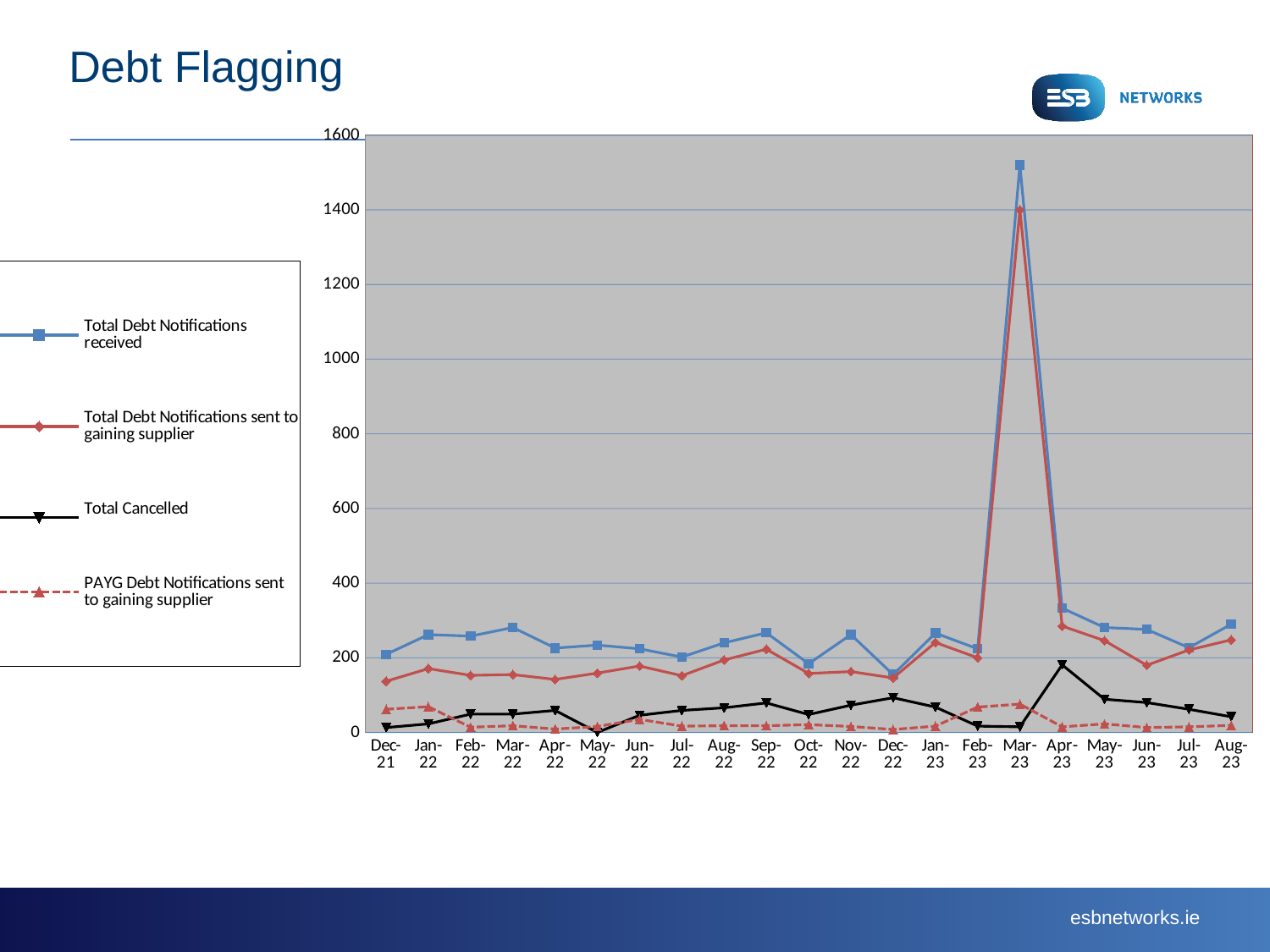
How many series does the legend list? 4 Does Total Debt Notifications received rise or fall from Mar-23 to Jul-23? Fall Is the value for Total Debt Notifications received in Mar-23 greater or less than 1400? greater Is the value for Total Debt Notifications sent to gaining supplier in Mar-23 greater or less than 1200? greater What is the title of the slide containing the chart? Debt Flagging In which month is Total Cancelled at its lowest? May-22 What kind of chart is shown on the slide? Line chart In which month does Total Cancelled reach its highest value? Apr-23 Is the value for Total Cancelled in Apr-23 greater or less than 200? less In which month does Total Debt Notifications received reach its highest value? Mar-23 In Mar-23, which is larger: Total Debt Notifications received or Total Debt Notifications sent to gaining supplier? Total Debt Notifications received How many months are plotted along the x axis? 21